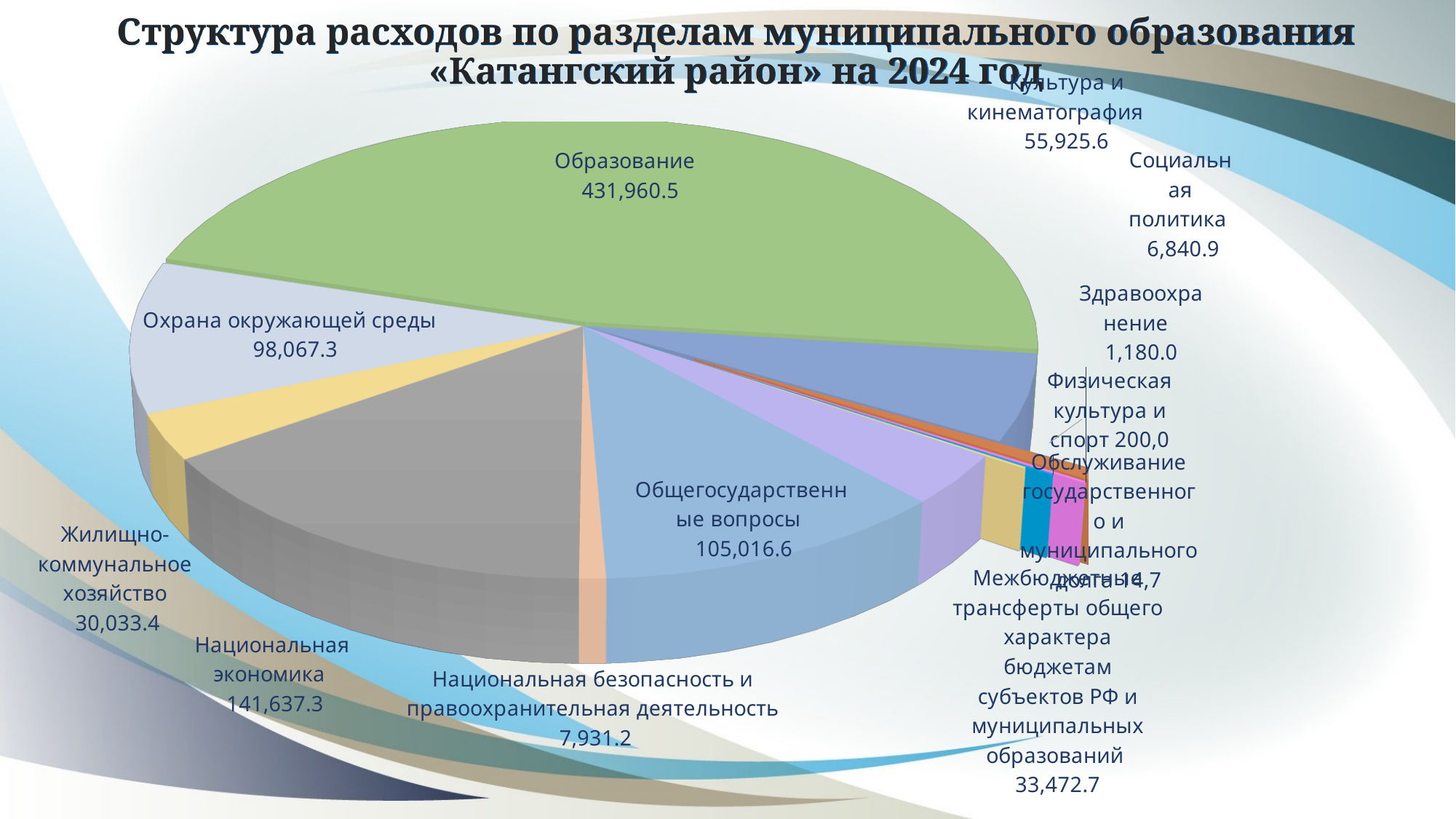
Which category has the largest share of the pie? Образование What is the value for Образование? 431,960.5 What is the value for Межбюджетные трансферты общего характера бюджетам субъектов РФ и муниципальных образований? 33,472.7 What is the value for Здравоохранение? 1,180.0 What is the title of the chart? Структура расходов по разделам муниципального образования «Катангский район» на 2024 год What kind of chart is shown on the slide? Pie chart What is the difference between Образование and Национальная экономика? 290,323.2 What is the difference between Культура и кинематография and Социальная политика? 49,084.7 What is the value for Охрана окружающей среды? 98,067.3 What is the value for Национальная экономика? 141,637.3 What is the value for Национальная безопасность и правоохранительная деятельность? 7,931.2 Which is larger: Национальная экономика or Общегосударственные вопросы? Национальная экономика